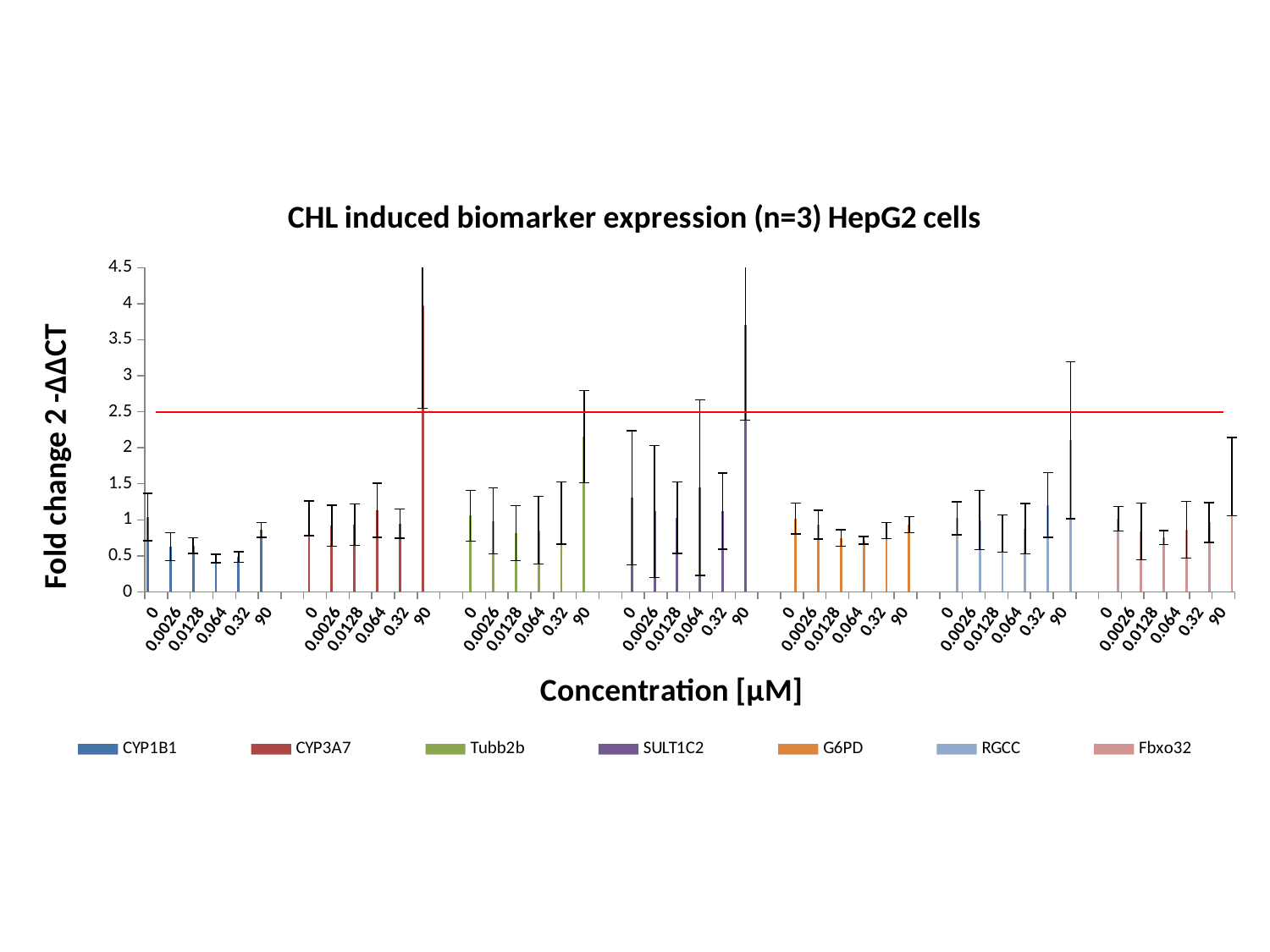
Is the value for SULT1C2 at 90 µM greater or less than 3? greater What is the title of the chart? CHL induced biomarker expression (n=3) HepG2 cells At which concentration is the SULT1C2 fold change highest? 90 At what fold change value is the horizontal red line drawn? 2.5 Is the value for Tubb2b at 90 µM greater or less than 1? greater Which is larger at 90 µM: the value for CYP3A7 or the value for Tubb2b? CYP3A7 At which concentration is the CYP3A7 fold change highest? 90 What kind of chart is shown on the slide? bar chart How many series does the legend list? 7 Is the value for CYP1B1 at 0.064 µM greater or less than 1? less How many concentration categories are plotted for each biomarker? 6